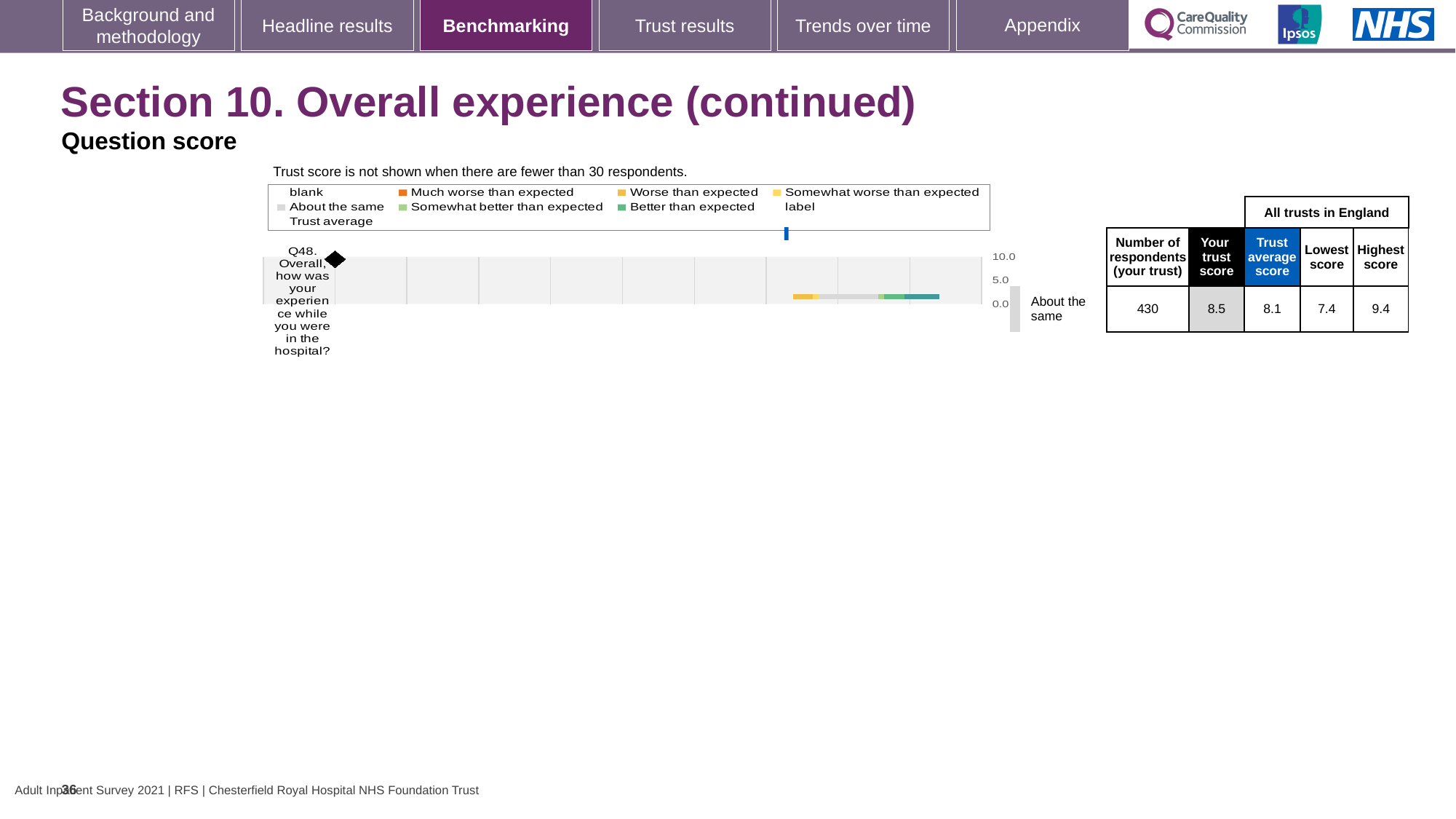
Which legend entry is shown in orange on the chart? Much worse than expected What is the highest score among all trusts in England for Q48? 9.4 What is the difference between the highest and lowest scores for Q48 across all trusts in England? 2.0 What is the lowest score among all trusts in England for Q48? 7.4 What is the trust score for Q48 shown on the slide? 8.5 Is the trust score for Q48 greater or less than 5.0 on the chart axis? greater Which benchmarking category is the trust's Q48 score placed in? About the same What is the trust average score for Q48 across all trusts in England? 8.1 How many respondents from the trust answered Q48? 430 What kind of chart is used to show the Q48 benchmarking result? Bar chart How many questions are plotted on the chart? 1 Which is larger for Q48: the trust's own score or the trust average score? Your trust score